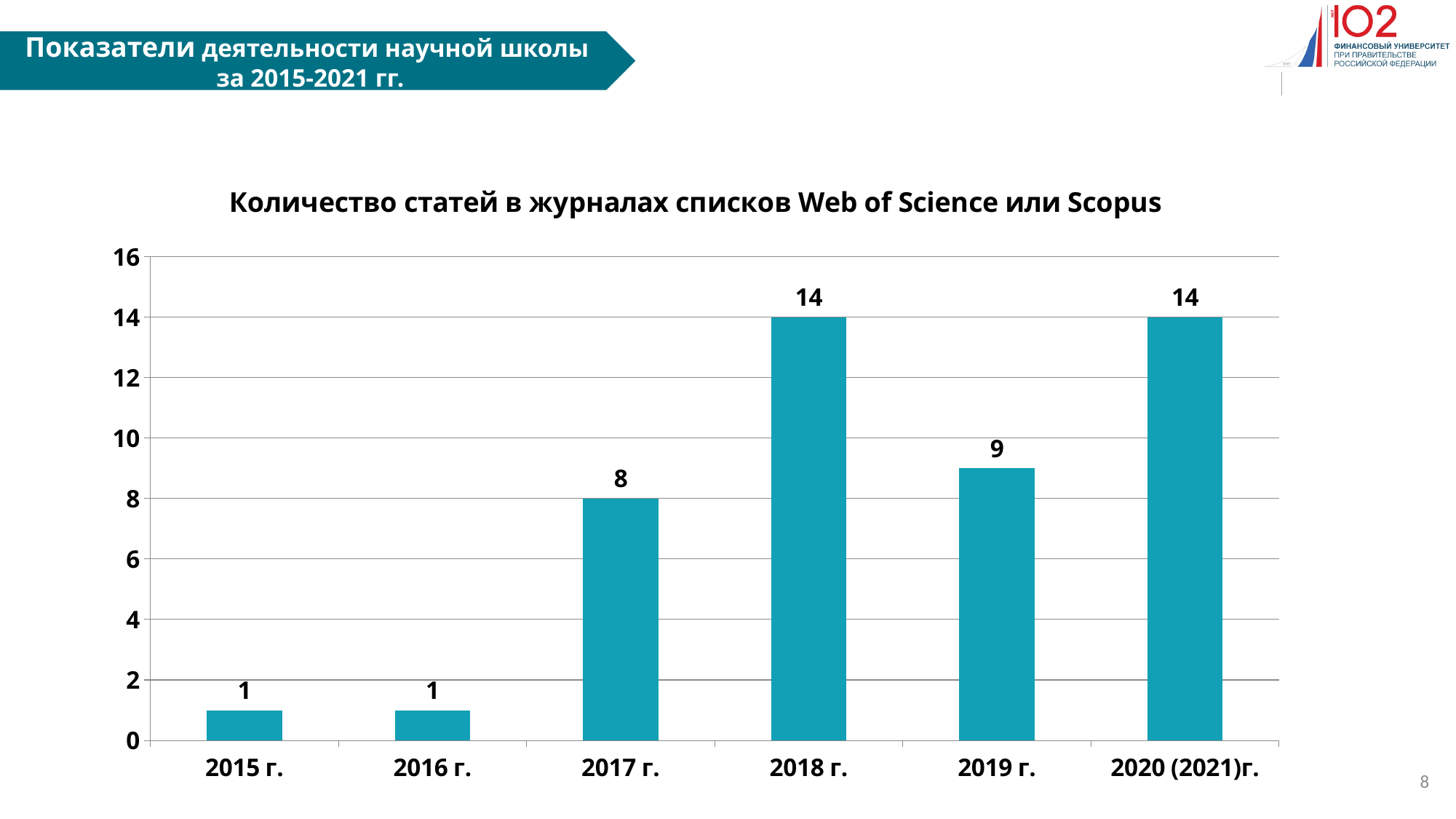
How many categories are shown on the x axis? 6 What is the value for 2017 г.? 8 Which is larger, the value for 2017 г. or the value for 2019 г.? 2019 г. What is the title of the chart? Количество статей в журналах списков Web of Science или Scopus What is the difference between the values for 2018 г. and 2019 г.? 5 What is the value for 2015 г.? 1 What is the value for 2019 г.? 9 Is the value for 2018 г. greater or less than 10? greater What is the difference between the values for 2017 г. and 2016 г.? 7 Which category has the lowest value, 2017 г. or 2019 г.? 2017 г. What is the value for 2020 (2021)г.? 14 What kind of chart is shown on the slide? bar chart